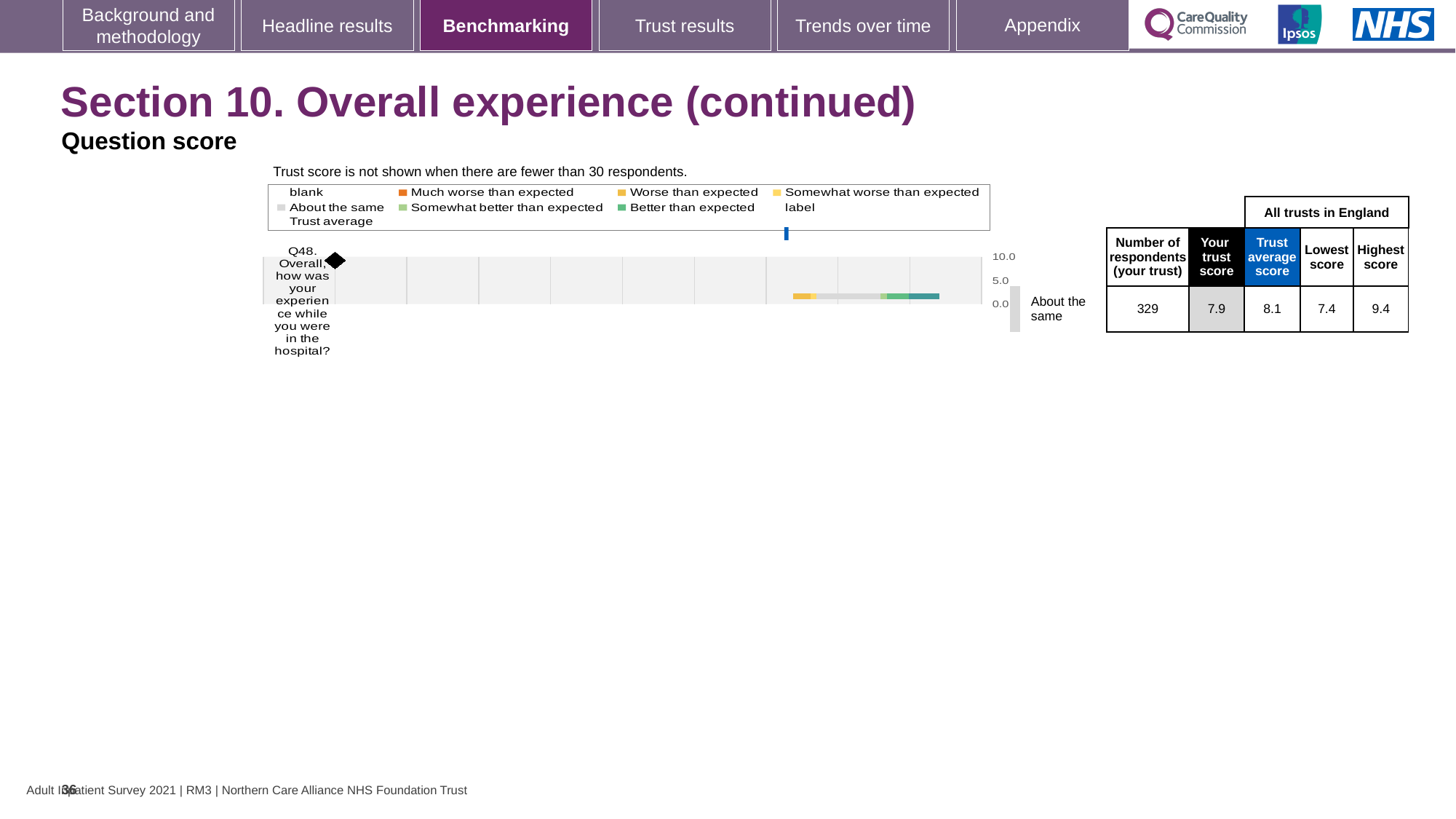
How many respondents from the trust answered Q48? 329 Is the trust's score for Q48 greater or less than 5.0 on the chart axis? greater According to the table beside the chart, what is the trust average score for Q48? 8.1 What kind of chart is shown on the slide for Q48? bar chart How many entries does the chart legend list? 9 According to the table beside the chart, what is the lowest score among all trusts in England for Q48? 7.4 What is the difference between the highest score and the lowest score for Q48? 2.0 According to the table beside the chart, what is the highest score among all trusts in England for Q48? 9.4 How many questions (categories) are plotted on the chart? 1 Which is larger for Q48: the trust's score or the trust average score? Trust average score What benchmark category label is shown next to the chart for Q48? About the same According to the table beside the chart, what is the trust's score for Q48? 7.9